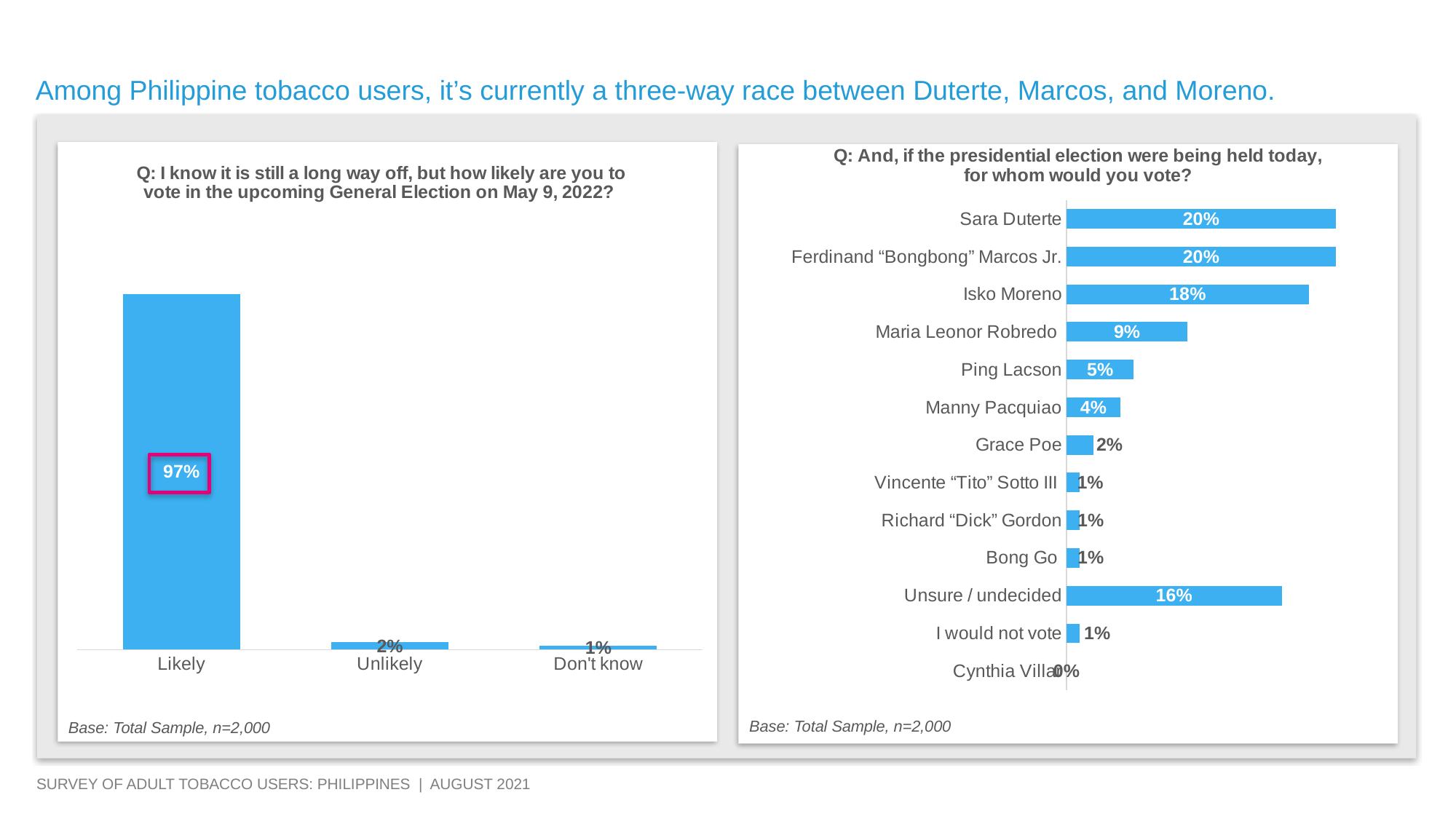
In the left chart on voting likelihood, what percentage of respondents said they are likely to vote? 97% What type of chart is the right chart on presidential vote choice? Bar chart In the right chart on presidential vote choice, what percentage are unsure or undecided? 16% In the left chart on voting likelihood, how many categories are shown on the x axis? 3 In the right chart on presidential vote choice, what percentage would vote for Maria Leonor Robredo? 9% In the right chart on presidential vote choice, how many categories are listed? 13 In the right chart on presidential vote choice, which is larger: the value for Ping Lacson or the value for Manny Pacquiao? Ping Lacson In the right chart on presidential vote choice, what is the difference between Sara Duterte's and Isko Moreno's values? 2% In the left chart on voting likelihood, what percentage answered 'Unlikely'? 2% In the left chart on voting likelihood, what is the difference between the 'Likely' and 'Unlikely' values? 95% In the right chart on presidential vote choice, which candidate has the lowest value? Cynthia Villar In the right chart on presidential vote choice, what percentage would vote for Isko Moreno? 18%